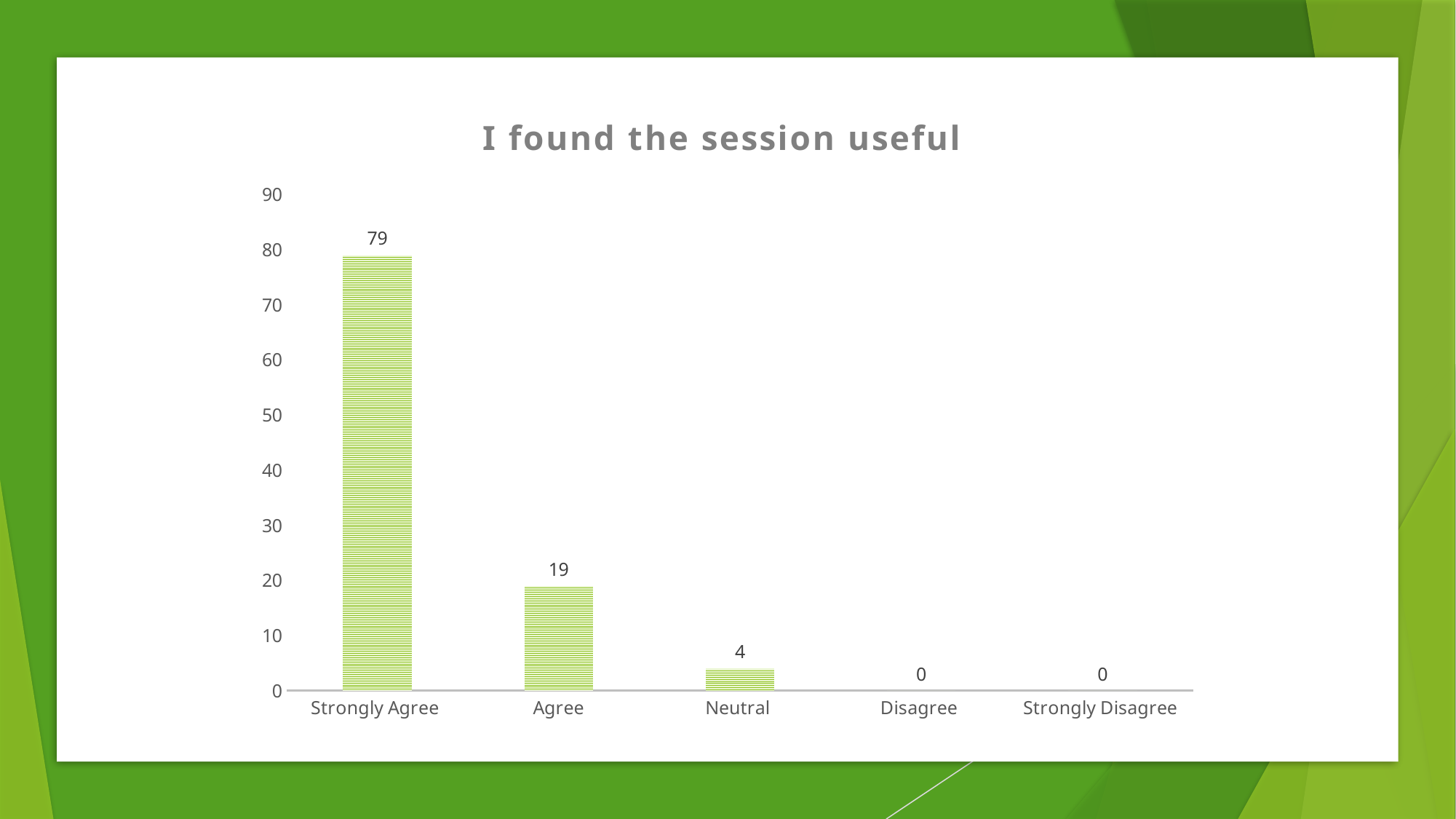
What is the title of the chart? I found the session useful What is the difference between the values for Strongly Agree and Agree? 60 What is the value for Strongly Agree? 79 What is the value for Disagree? 0 What kind of chart is shown on the slide? bar chart Is the value for Strongly Agree greater or less than 70? greater Which category has the highest value? Strongly Agree What is the value for Agree? 19 How many categories are shown on the x axis? 5 What is the difference between the values for Agree and Neutral? 15 Which is larger, the value for Agree or the value for Neutral? Agree What is the value for Neutral? 4